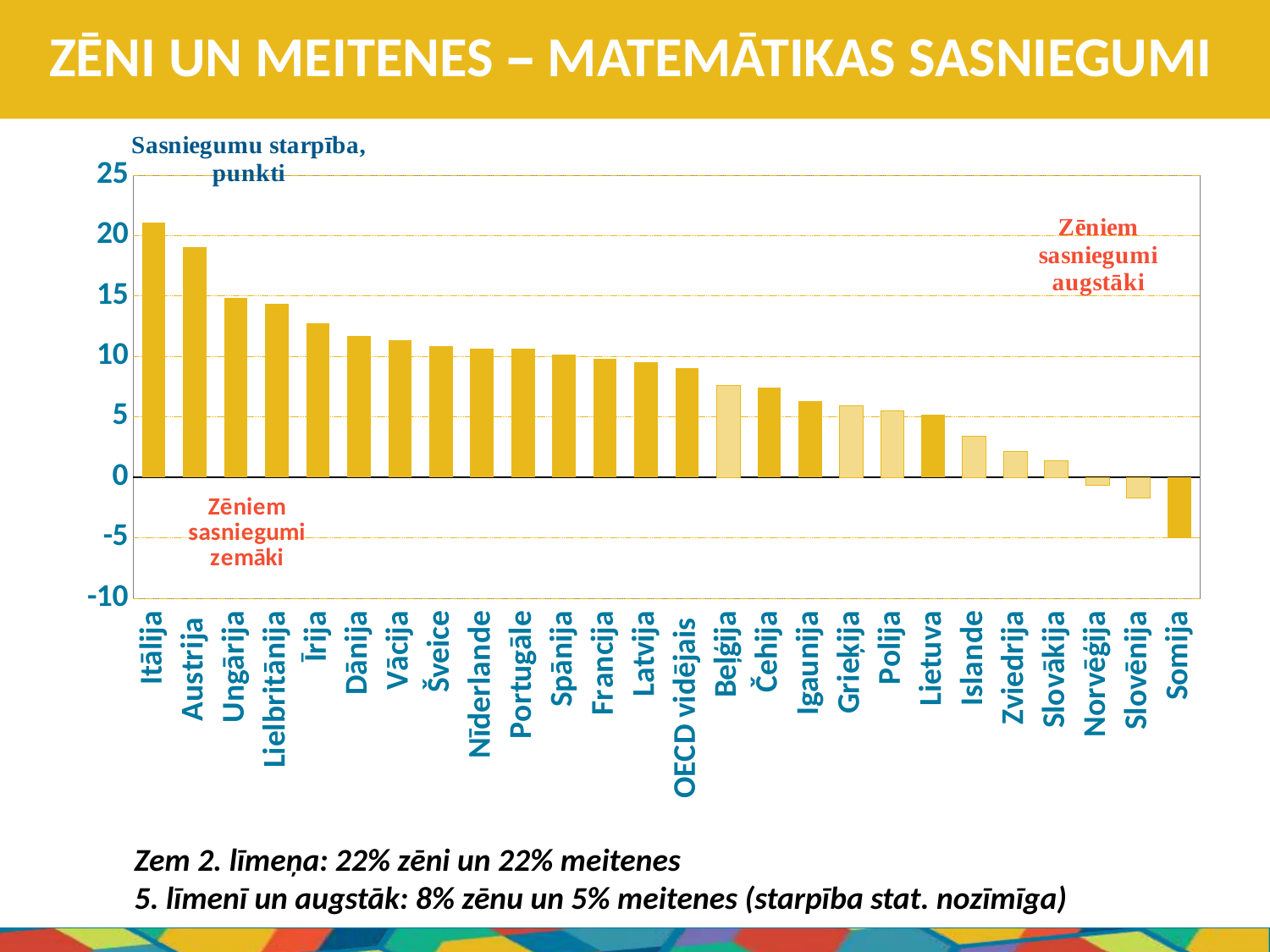
Which has the larger value, Dānija or Islande? Dānija Which country has the lowest value in the chart? Somija What kind of chart is shown on the slide? bar chart Is the value for Itālija greater or less than 20? greater Is the value for Lielbritānija greater or less than 15? less What is the label of the vertical axis? Sasniegumu starpība, punkti How many countries/categories are shown on the x axis? 26 Is the value for Somija greater or less than 0? less Which country has the highest value in the chart? Itālija Do the values rise or fall from left to right along the x axis? fall